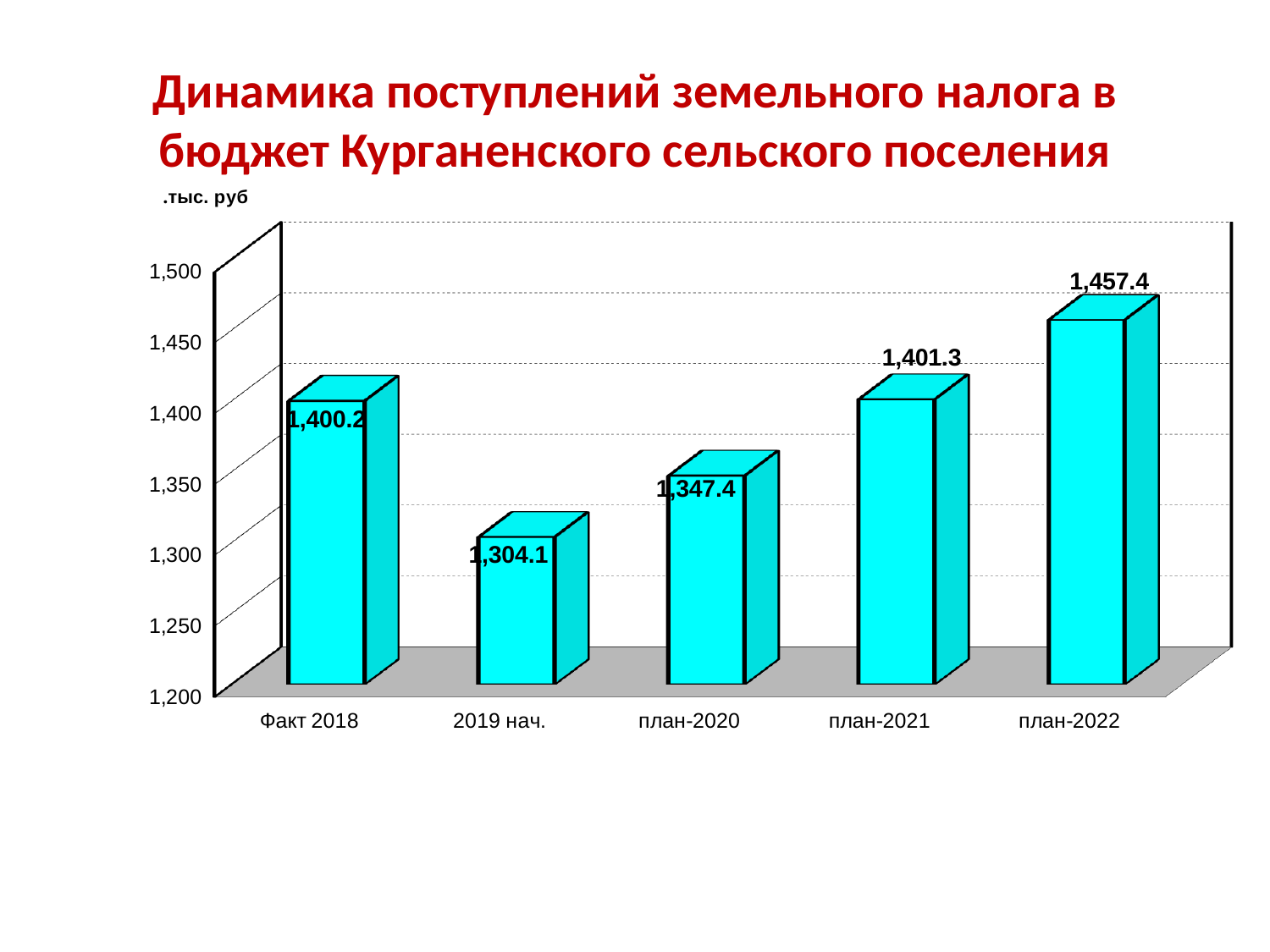
Which category has the highest value? план-2022 From 2019 нач. to план-2022, do the values rise or fall? rise How many categories are shown on the x axis? 5 Is the value for 2019 нач. greater or less than 1,350? less What is the value for план-2020? 1,347.4 What is the difference between the values for Факт 2018 and 2019 нач.? 96.1 What kind of chart is shown on the slide? bar chart What is the value for 2019 нач.? 1,304.1 What is the value for план-2022? 1,457.4 Which category has the lowest value? 2019 нач. What is the difference between the values for план-2022 and план-2021? 56.1 Which is larger, the value for план-2020 or the value for 2019 нач.? план-2020